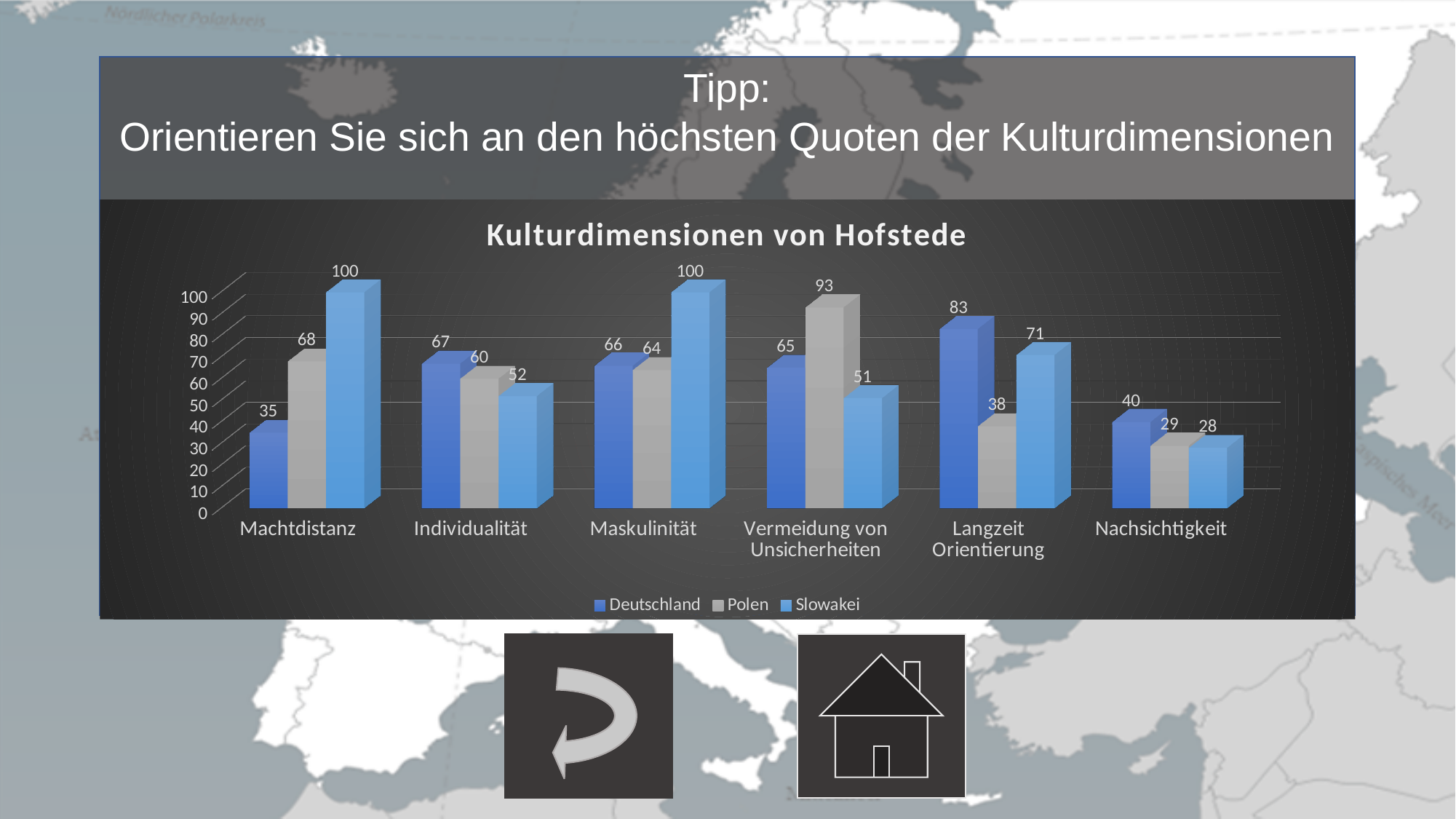
Which is larger in the Individualität category: the value for Deutschland or the value for Polen? Deutschland What is the value for Deutschland in the Machtdistanz category? 35 Which country has the highest value in the Langzeit Orientierung category? Deutschland In which categories does Slowakei reach a value of 100? Machtdistanz and Maskulinität What is the title of the chart? Kulturdimensionen von Hofstede How many series does the legend list? 3 What kind of chart is shown on the slide? Bar chart What is the value for Polen in the Vermeidung von Unsicherheiten category? 93 What is the value for Slowakei in the Langzeit Orientierung category? 71 Which country has the lowest value in the Nachsichtigkeit category? Slowakei What is the difference between the Slowakei and Deutschland values in the Machtdistanz category? 65 How many categories are shown on the x axis? 6